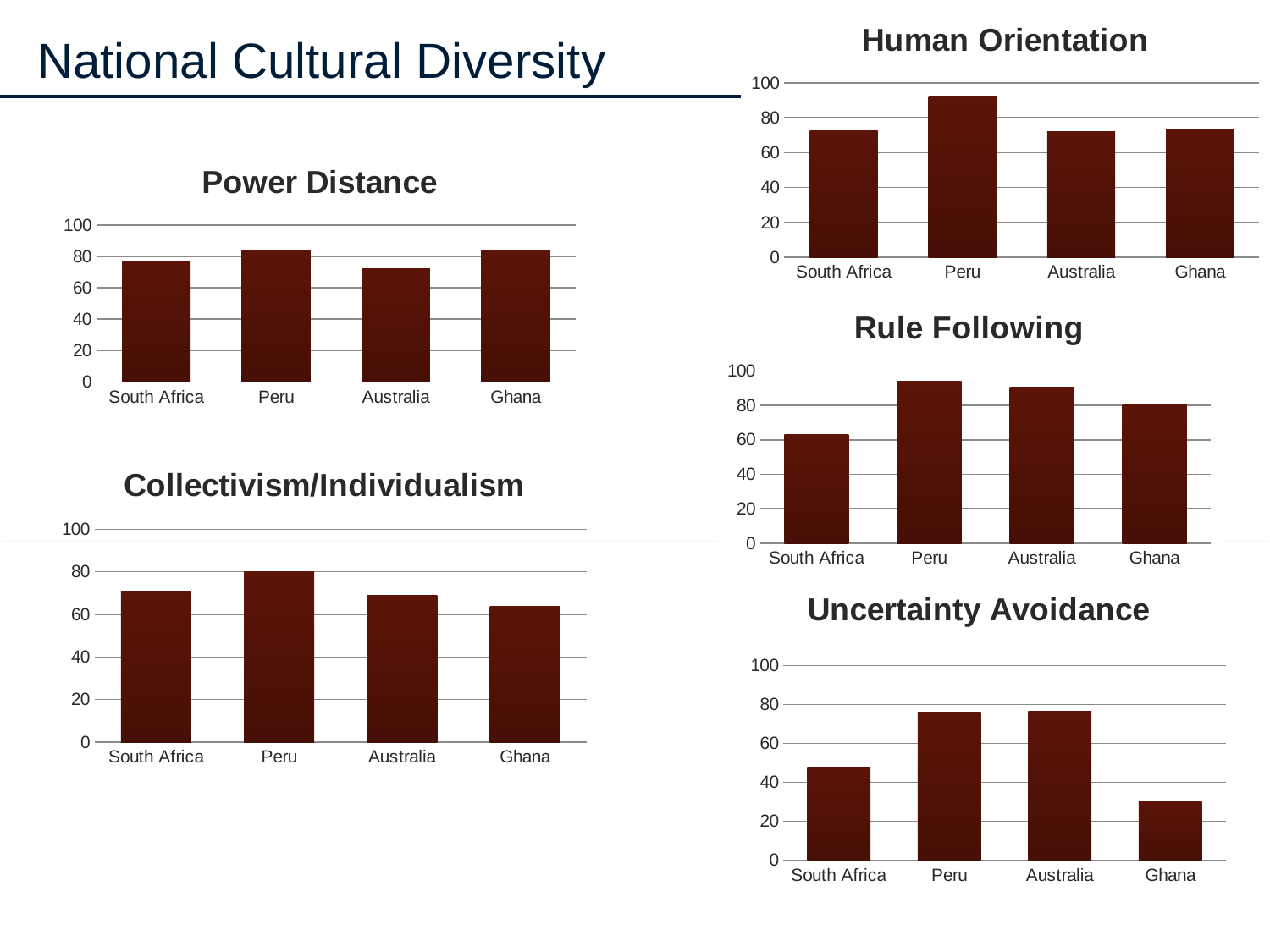
In the Uncertainty Avoidance chart, is the value for Ghana greater or less than 40? less In the Human Orientation chart, which country has the highest value? Peru In the Power Distance chart, is the value for Australia greater or less than 80? less In the Rule Following chart, is the value for Peru greater or less than 80? greater What kind of chart is the Rule Following chart? bar chart In the Uncertainty Avoidance chart, which is larger, the value for Peru or the value for Ghana? Peru How many countries are shown in the Power Distance chart? 4 In the Human Orientation chart, which is larger, the value for Peru or the value for Australia? Peru In the Uncertainty Avoidance chart, which country has the lowest value? Ghana In the Collectivism/Individualism chart, which country has the highest value? Peru In the Rule Following chart, which country has the lowest value? South Africa